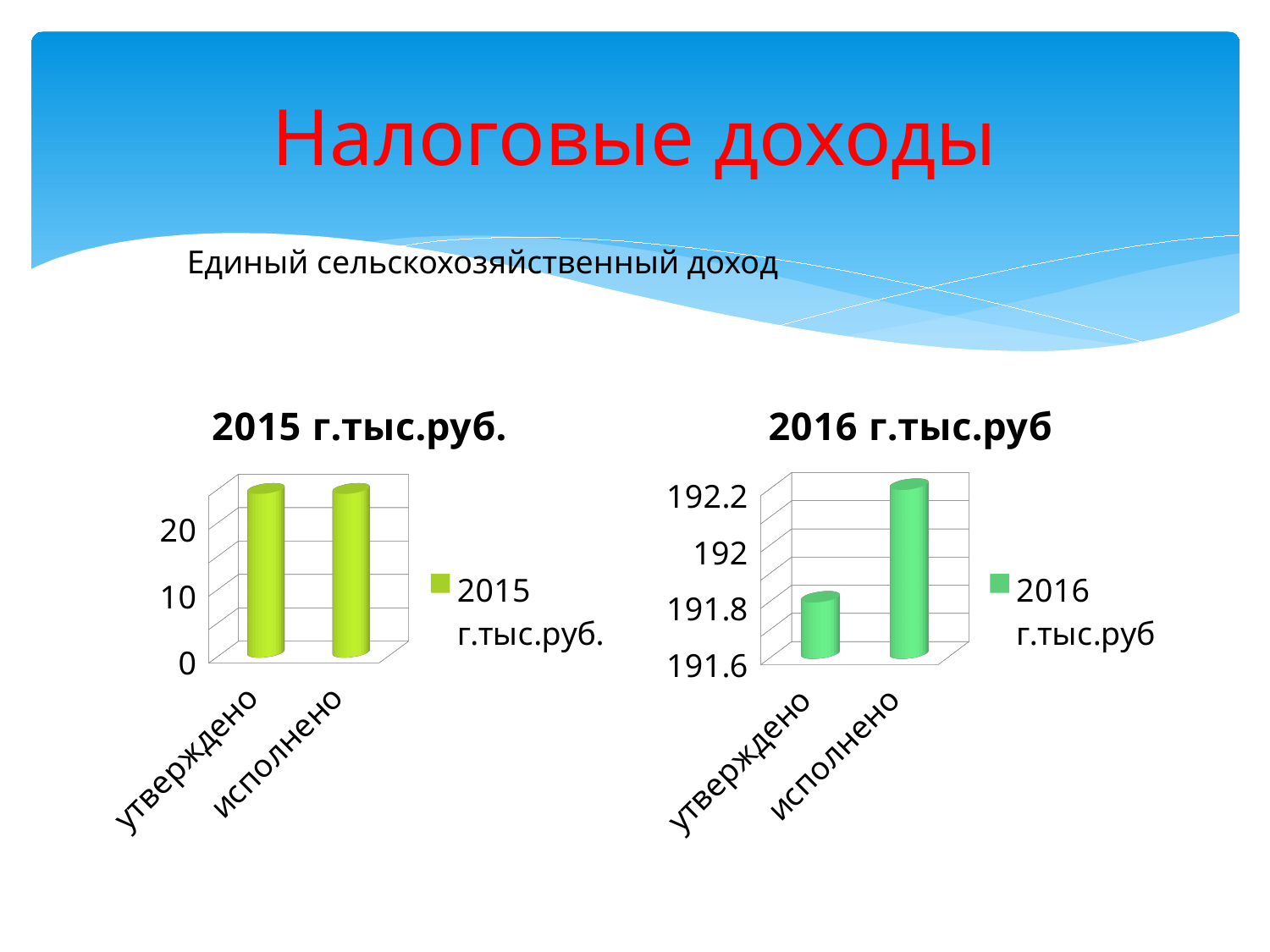
In the chart titled "2016 г.тыс.руб", is the value for утверждено greater or less than 192? less What kind of chart is the chart titled "2016 г.тыс.руб"? bar chart In the chart titled "2016 г.тыс.руб", which category has the highest value? исполнено In the chart titled "2016 г.тыс.руб", how many categories are shown on the x axis? 2 In the chart titled "2015 г.тыс.руб.", how many categories are shown on the x axis? 2 What is the legend entry in the chart titled "2016 г.тыс.руб"? 2016 г.тыс.руб What kind of chart is the chart titled "2015 г.тыс.руб."? bar chart In the chart titled "2015 г.тыс.руб.", is the value for утверждено greater or less than 20? greater In the chart titled "2015 г.тыс.руб.", how many series does the legend list? 1 In the chart titled "2016 г.тыс.руб", is the value for исполнено greater or less than 192? greater In the chart titled "2016 г.тыс.руб", how many series does the legend list? 1 In the chart titled "2016 г.тыс.руб", which is larger, утверждено or исполнено? исполнено